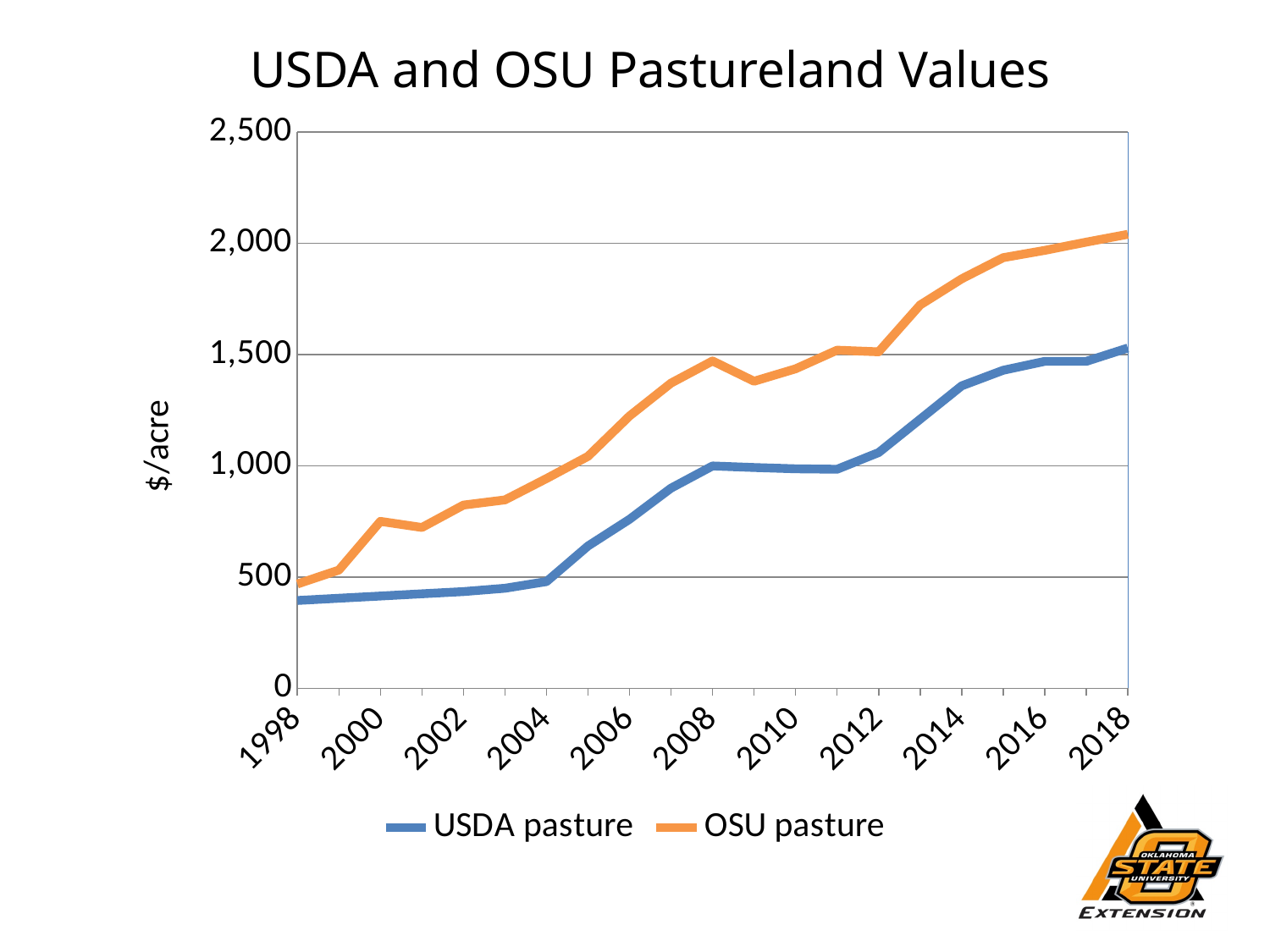
What kind of chart is shown on the slide? line chart How many series does the legend list? 2 Is the OSU pasture value in 2014 greater or less than 1,500? greater What is the title of the chart? USDA and OSU Pastureland Values In which year is the OSU pasture value highest? 2018 In which year is the USDA pasture value lowest? 1998 Which series has the higher value in 2010, USDA pasture or OSU pasture? OSU pasture Is the USDA pasture value in 1998 greater or less than 500? less Is the USDA pasture value in 2014 greater or less than 1,500? less Do the USDA pasture values generally rise or fall from 1998 to 2018? rise What is the label on the vertical axis? $/acre